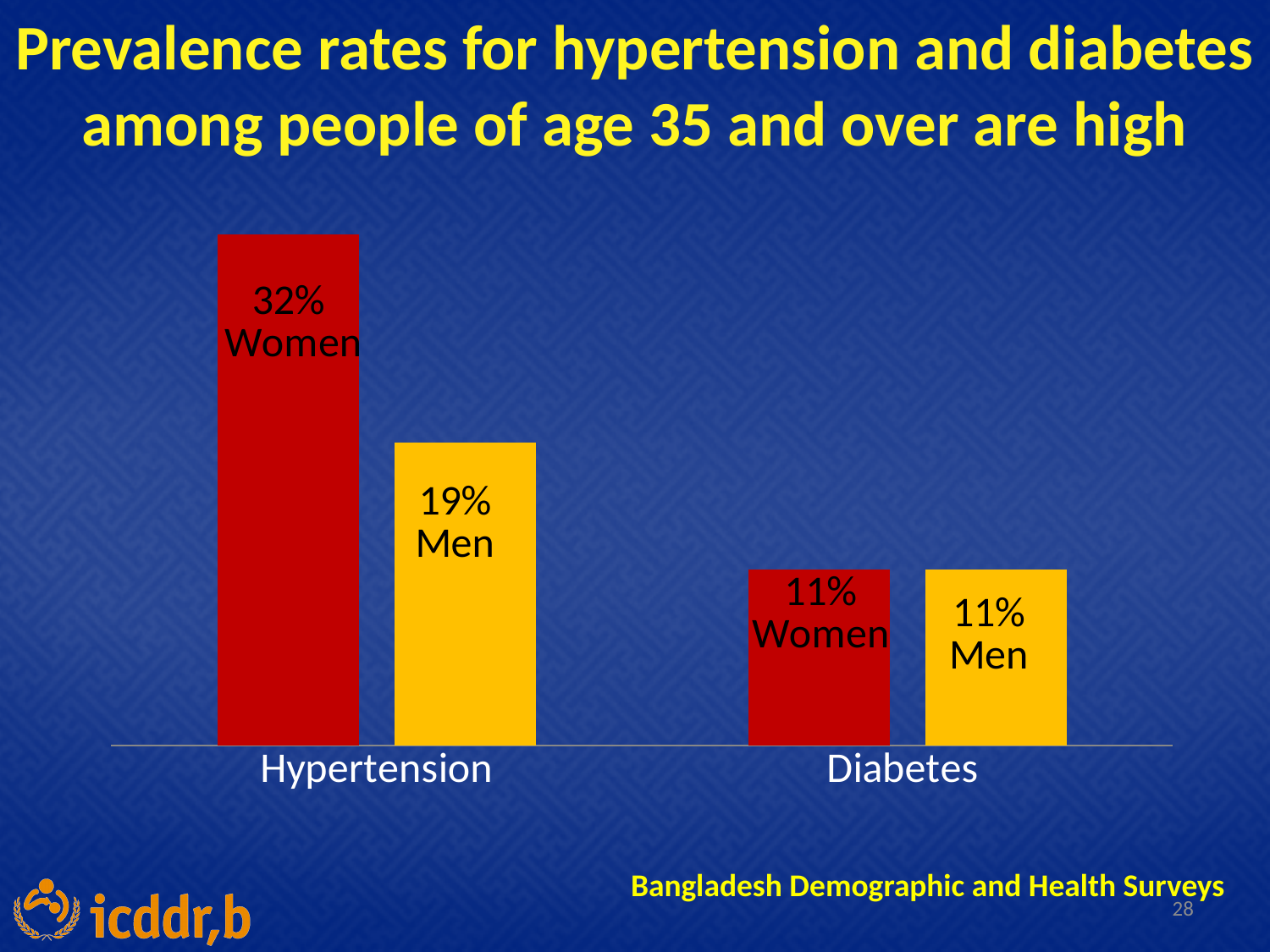
What is the hypertension prevalence rate for women? 32% What is the diabetes prevalence rate for women? 11% How many bars are plotted in the chart? 4 Which bar shows the highest prevalence rate? Women, Hypertension What is the diabetes prevalence rate for men? 11% How many condition categories are shown on the x axis? 2 What kind of chart is shown on the slide? Bar chart What is the difference between the hypertension rate and the diabetes rate for women? 21% What colour are the bars representing women? Red What is the hypertension prevalence rate for men? 19% What is the difference between the hypertension rates for women and men? 13% Which is larger, the hypertension rate for women or the hypertension rate for men? Women